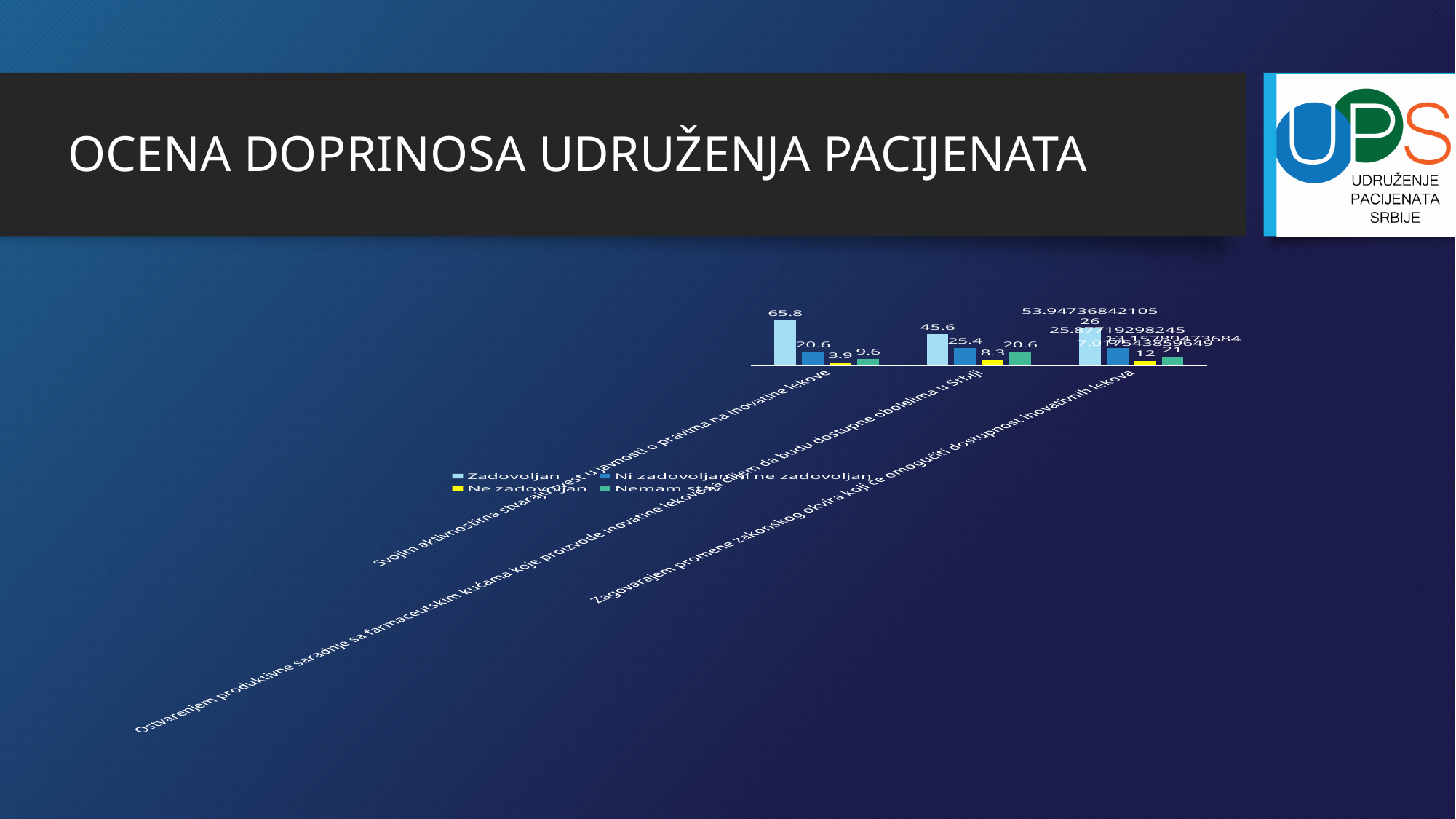
What is the difference between the Zadovoljan value (65.8) and the Ni zadovoljan ni ne zadovoljan value (20.6) in the category 'Svojim aktivnostima stvarajući svest u javnosti o pravima na inovativne lekove'? 45.2 How many categories are plotted along the x axis of the chart? 3 What is the Ne zadovoljan value for the category 'Svojim aktivnostima stvarajući svest u javnosti o pravima na inovativne lekove'? 3.9 Which series has the highest value in the category 'Svojim aktivnostima stvarajući svest u javnosti o pravima na inovativne lekove'? Zadovoljan Which series has the lowest value in the category 'Ostvarenjem produktivne saradnje sa farmaceutskim kućama koje proizvode inovativne lekove'? Ne zadovoljan What is the Nemam stav value for the category 'Svojim aktivnostima stvarajući svest u javnosti o pravima na inovativne lekove'? 9.6 What kind of chart is shown on the slide? bar chart Which is larger: the Nemam stav value for 'Svojim aktivnostima stvarajući svest u javnosti o pravima na inovativne lekove' or the Nemam stav value for 'Ostvarenjem produktivne saradnje sa farmaceutskim kućama koje proizvode inovativne lekove'? Ostvarenjem produktivne saradnje sa farmaceutskim kućama koje proizvode inovativne lekove What is the Zadovoljan value for the category 'Svojim aktivnostima stvarajući svest u javnosti o pravima na inovativne lekove'? 65.8 How many series does the chart legend list? 4 What is the Zadovoljan value for the category 'Ostvarenjem produktivne saradnje sa farmaceutskim kućama koje proizvode inovativne lekove'? 45.6 What is the Ni zadovoljan ni ne zadovoljan value for the category 'Ostvarenjem produktivne saradnje sa farmaceutskim kućama koje proizvode inovativne lekove'? 25.4